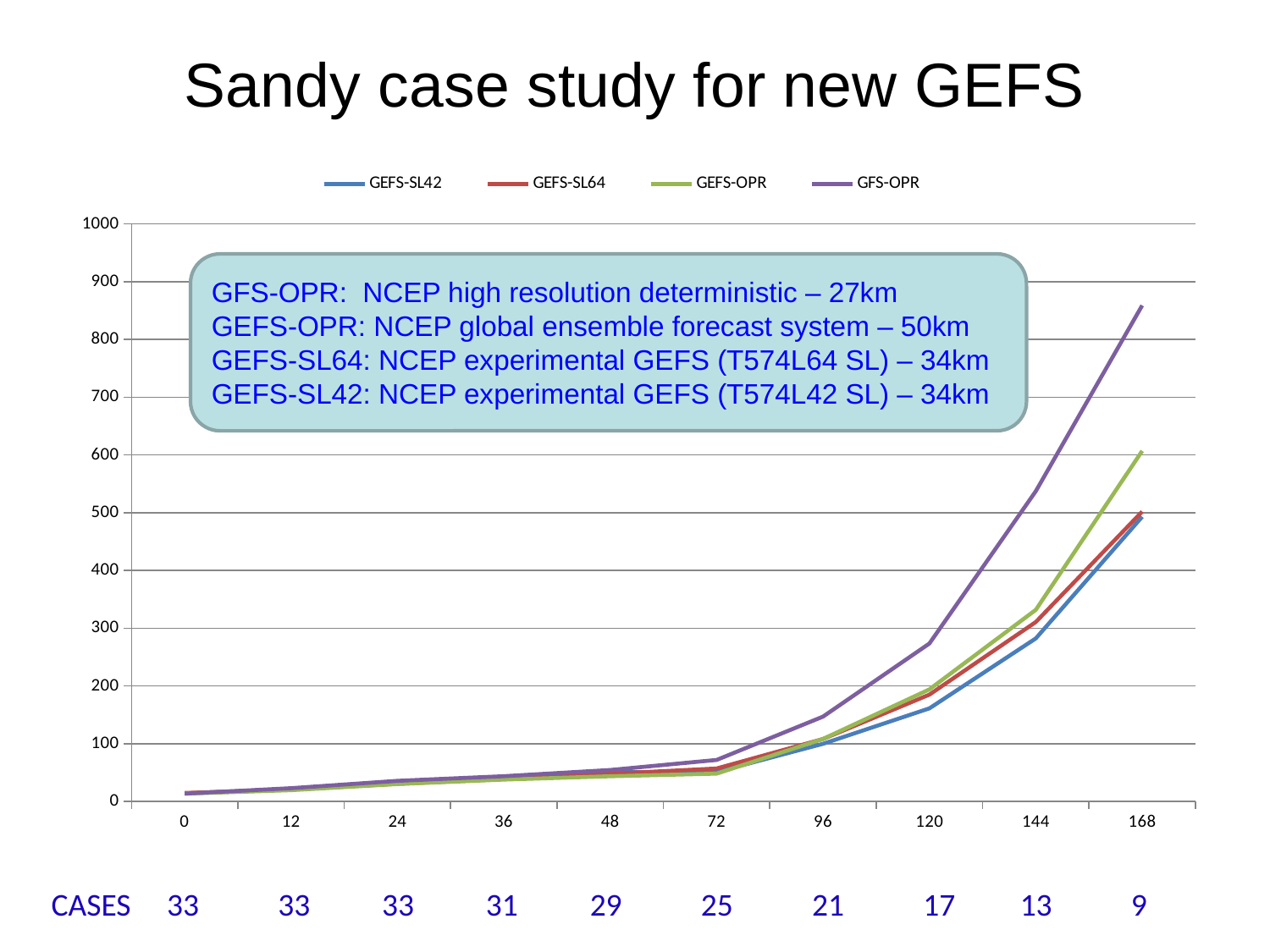
What is the title of the slide containing the chart? Sandy case study for new GEFS Is the value for GEFS-SL42 at forecast hour 168 greater or less than 600? less Is the value for GFS-OPR at forecast hour 120 greater or less than 200? greater Is the value for GEFS-OPR at forecast hour 168 greater or less than 500? greater How many cases are listed below the chart for forecast hour 168? 9 What kind of chart is shown on the slide? line chart How many series does the legend list? 4 Which series has the highest value at forecast hour 168? GFS-OPR How many forecast hour points are labelled on the x axis? 10 Do the values for GFS-OPR rise or fall as forecast hour increases from 0 to 168? rise At forecast hour 144, which is larger: GFS-OPR or GEFS-OPR? GFS-OPR